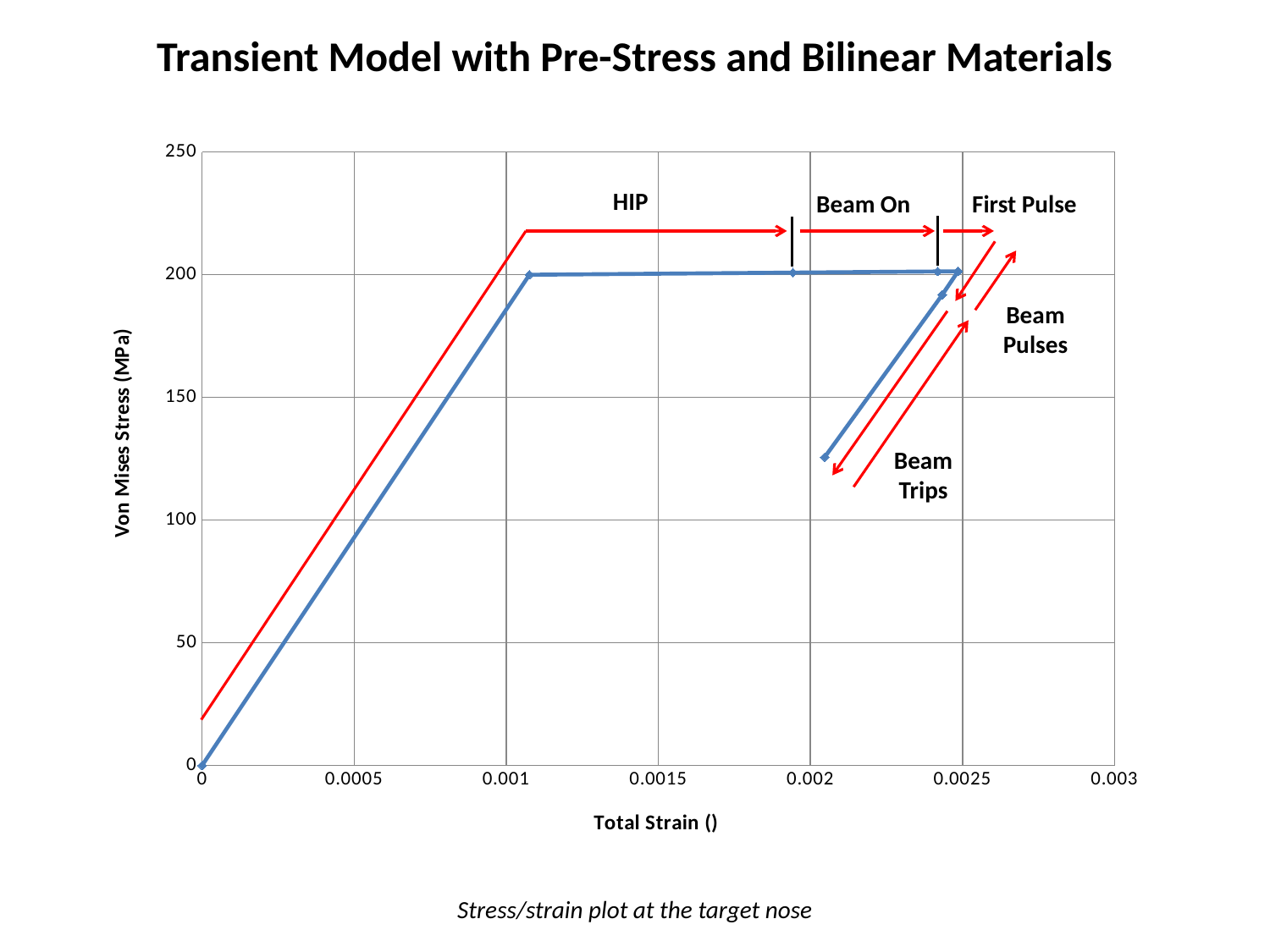
What kind of chart is shown on the slide? line chart Is the Von Mises stress on the plateau of the blue curve greater or less than 150? greater Is the stress at a total strain of 0.0005 greater or less than 50? greater Is the lowest stress reached after the beam trips greater or less than 100? greater What is the Von Mises stress at a total strain of 0? 0 What is the label of the vertical axis? Von Mises Stress (MPa) Does the Von Mises stress rise or fall as total strain increases from 0 to 0.001? rise What is the title of the chart? Transient Model with Pre-Stress and Bilinear Materials